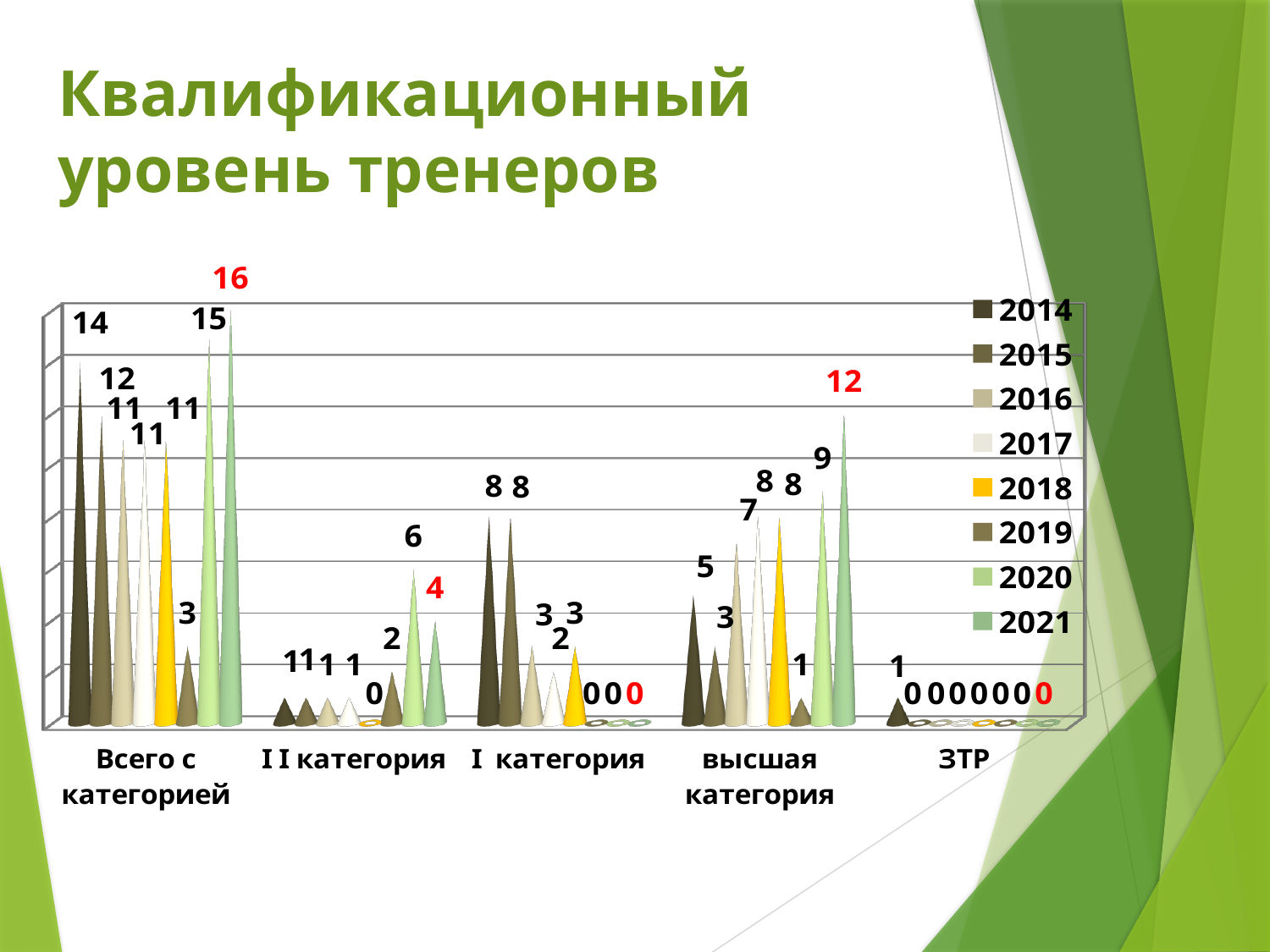
What is the value for 2020 in the "II категория" category? 6 What type of chart is shown on the slide? Bar chart What is the difference between the 2021 and 2020 values in the "Всего с категорией" category? 1 Which is larger in the "I категория" category: the value for 2014 or the value for 2016? 2014 Which year has the lowest value in the "Всего с категорией" category? 2019 What is the value for 2021 in the "Всего с категорией" category? 16 What is the value for 2021 in the "высшая категория" category? 12 What is the value for 2014 in the "Всего с категорией" category? 14 Which year has the highest value in the "высшая категория" category? 2021 How many categories are shown on the x axis? 5 What is the value for 2014 in the "ЗТР" category? 1 How many series does the legend list? 8